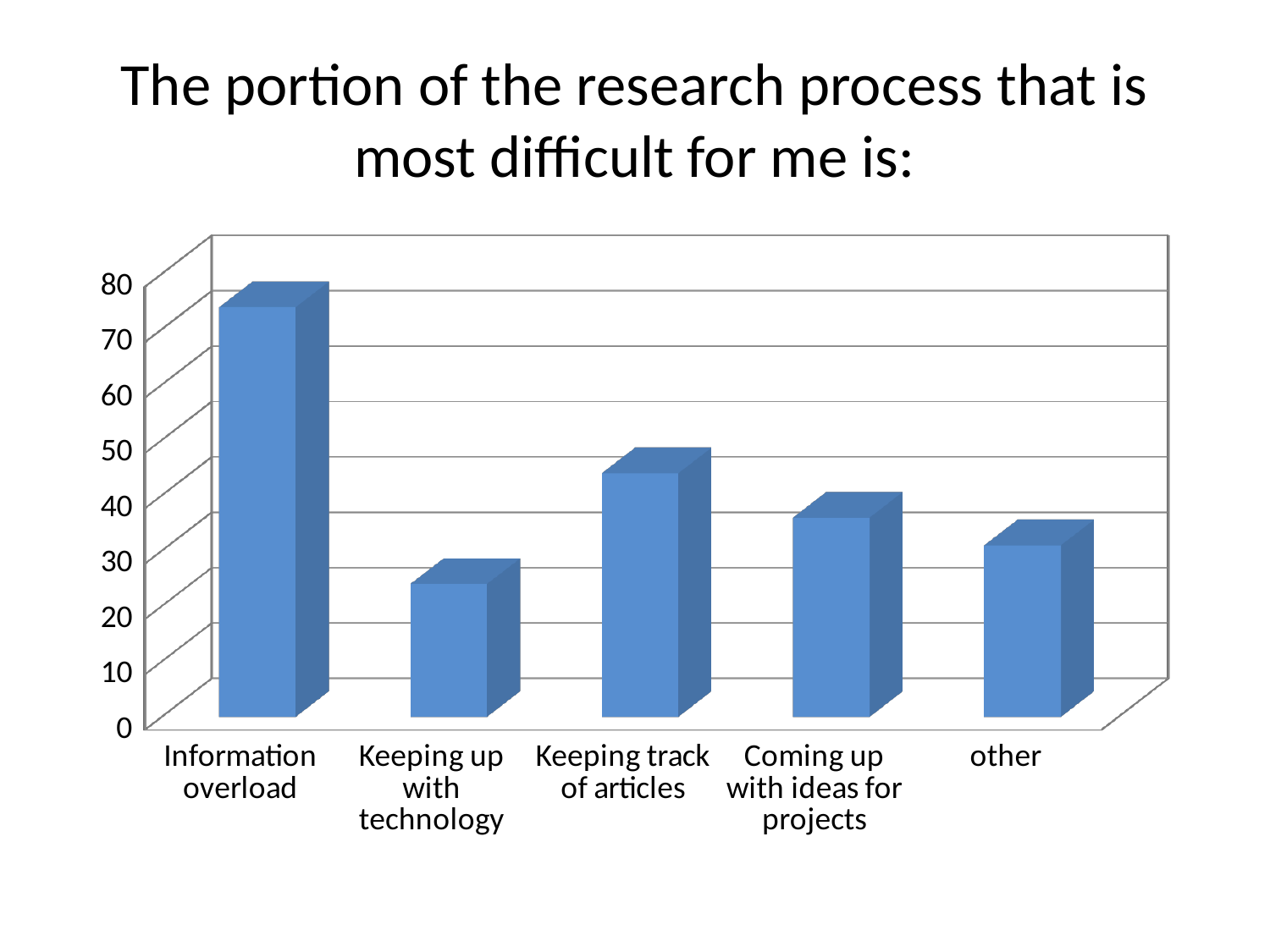
Which category has the lowest value in the chart? Keeping up with technology What is the title of the slide containing the chart? The portion of the research process that is most difficult for me is: What kind of chart is shown on the slide? bar chart Is the value for Coming up with ideas for projects greater or less than 30? greater Is the value for Keeping up with technology greater or less than 30? less How many categories are shown on the x axis of the chart? 5 Which is larger, the value for Keeping track of articles or the value for Coming up with ideas for projects? Keeping track of articles Which category has the highest value in the chart? Information overload Which is larger, the value for other or the value for Keeping up with technology? other Is the value for other greater or less than 40? less